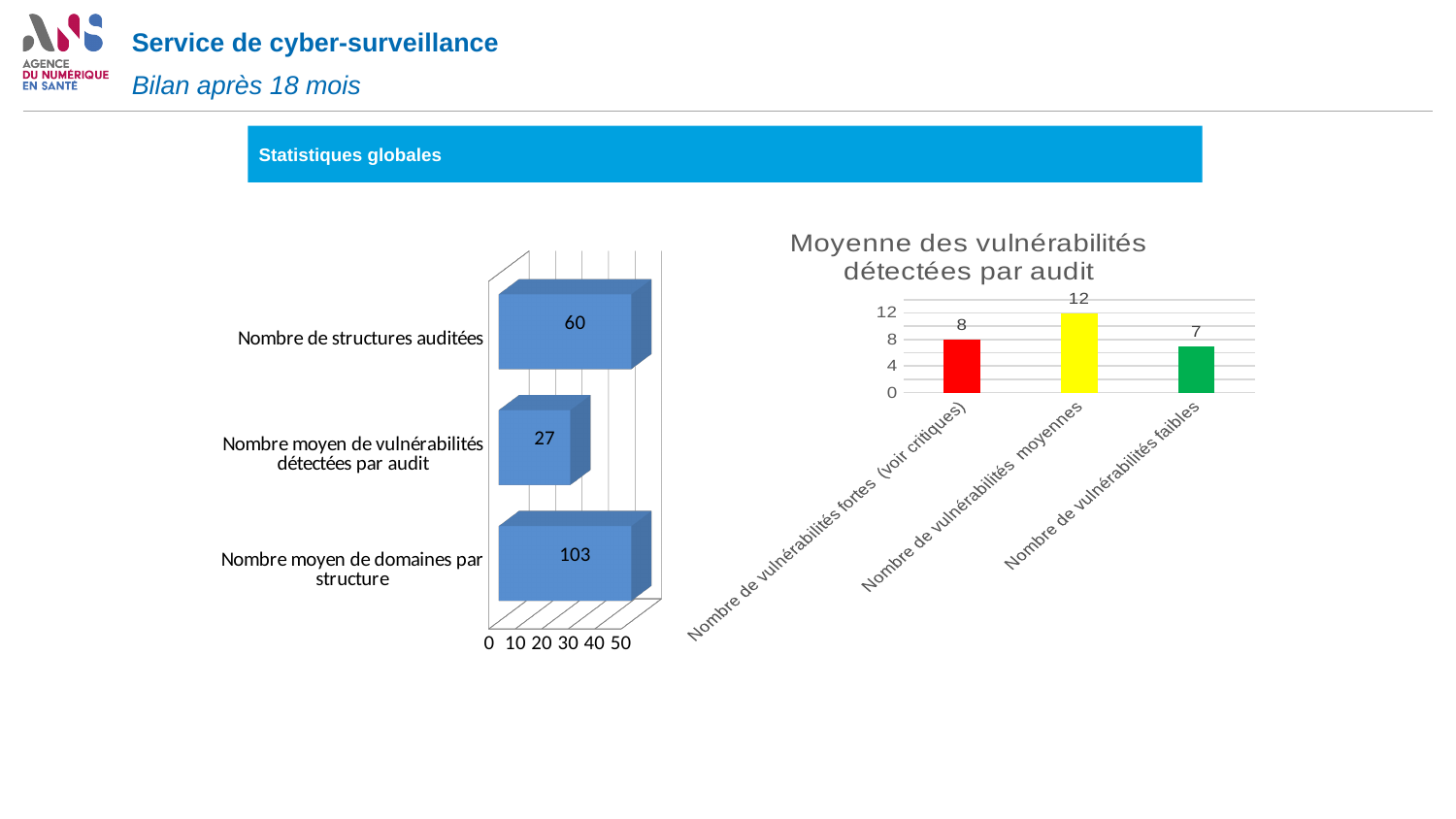
In the chart 'Moyenne des vulnérabilités détectées par audit', what is the difference between 'Nombre de vulnérabilités fortes (voir critiques)' and 'Nombre de vulnérabilités faibles'? 1 In the left chart, which category has the lowest value? Nombre moyen de vulnérabilités détectées par audit In the left chart, how many categories are shown? 3 In the left chart, what is the value for 'Nombre moyen de vulnérabilités détectées par audit'? 27 In the left chart, what is the value for 'Nombre moyen de domaines par structure'? 103 In the left chart, which category has the highest value? Nombre moyen de domaines par structure In the chart 'Moyenne des vulnérabilités détectées par audit', which category has the highest value? Nombre de vulnérabilités moyennes In the left chart, what is the value for 'Nombre de structures auditées'? 60 In the left chart, what is the difference between 'Nombre moyen de domaines par structure' and 'Nombre de structures auditées'? 43 What kind of chart is 'Moyenne des vulnérabilités détectées par audit'? Bar chart In the chart 'Moyenne des vulnérabilités détectées par audit', what is the value for 'Nombre de vulnérabilités faibles'? 7 In the chart 'Moyenne des vulnérabilités détectées par audit', what is the value for 'Nombre de vulnérabilités moyennes'? 12